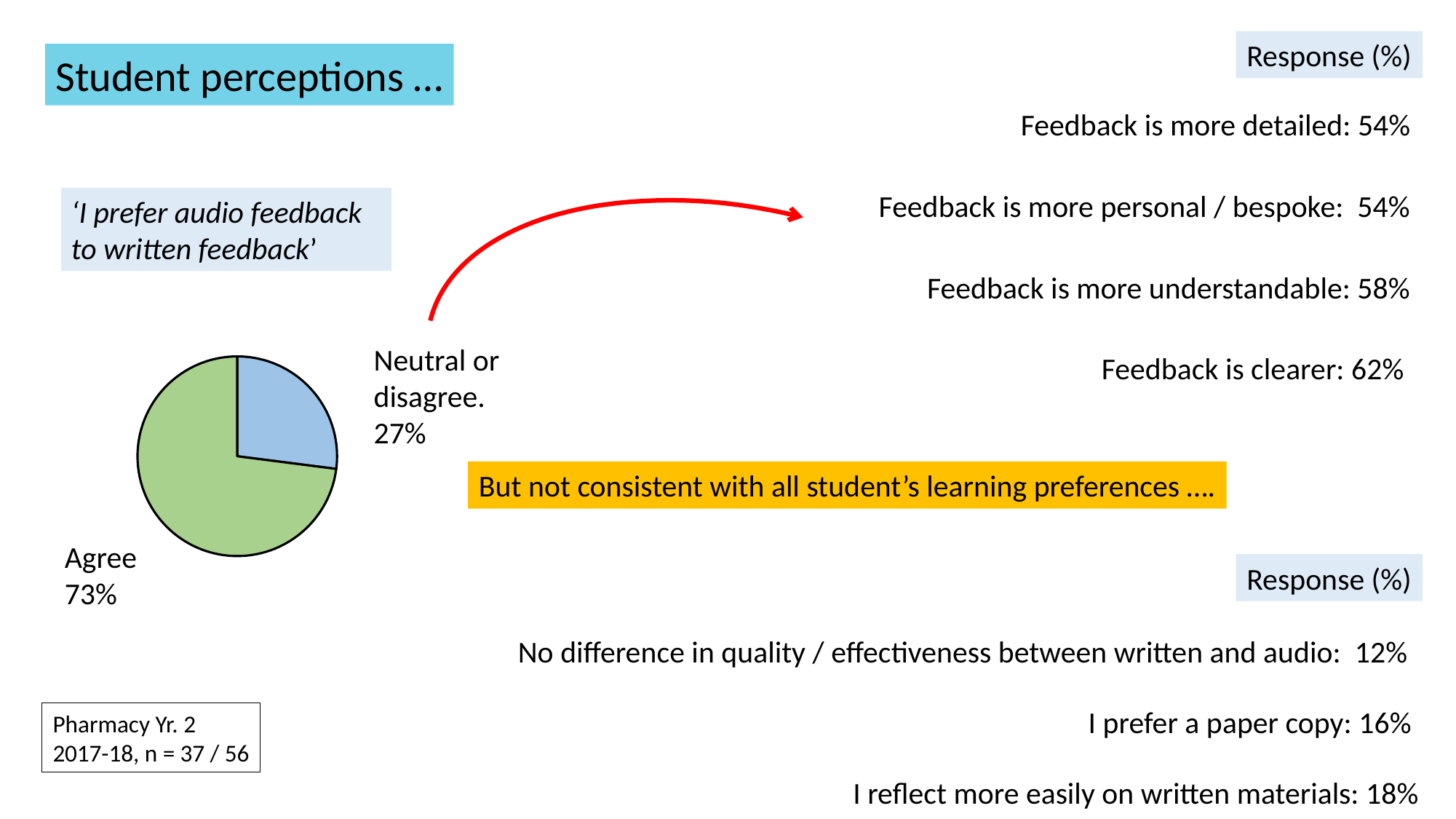
Which slice of the pie chart is the largest? Agree What is the difference in percentage points between the Agree slice and the Neutral or disagree slice? 46 What kind of chart is shown on the slide? pie chart Which is larger in the pie chart: Agree or Neutral or disagree? Agree What colour is the Agree slice of the pie chart? green What percentage of students were neutral or disagreed with the statement 'I prefer audio feedback to written feedback'? 27% How many slices does the pie chart have? 2 What statement does the pie chart show student responses to? 'I prefer audio feedback to written feedback' What percentage of students agreed with the statement 'I prefer audio feedback to written feedback'? 73% What share of the pie does the Agree slice represent? 73% Which slice of the pie chart is the smallest? Neutral or disagree